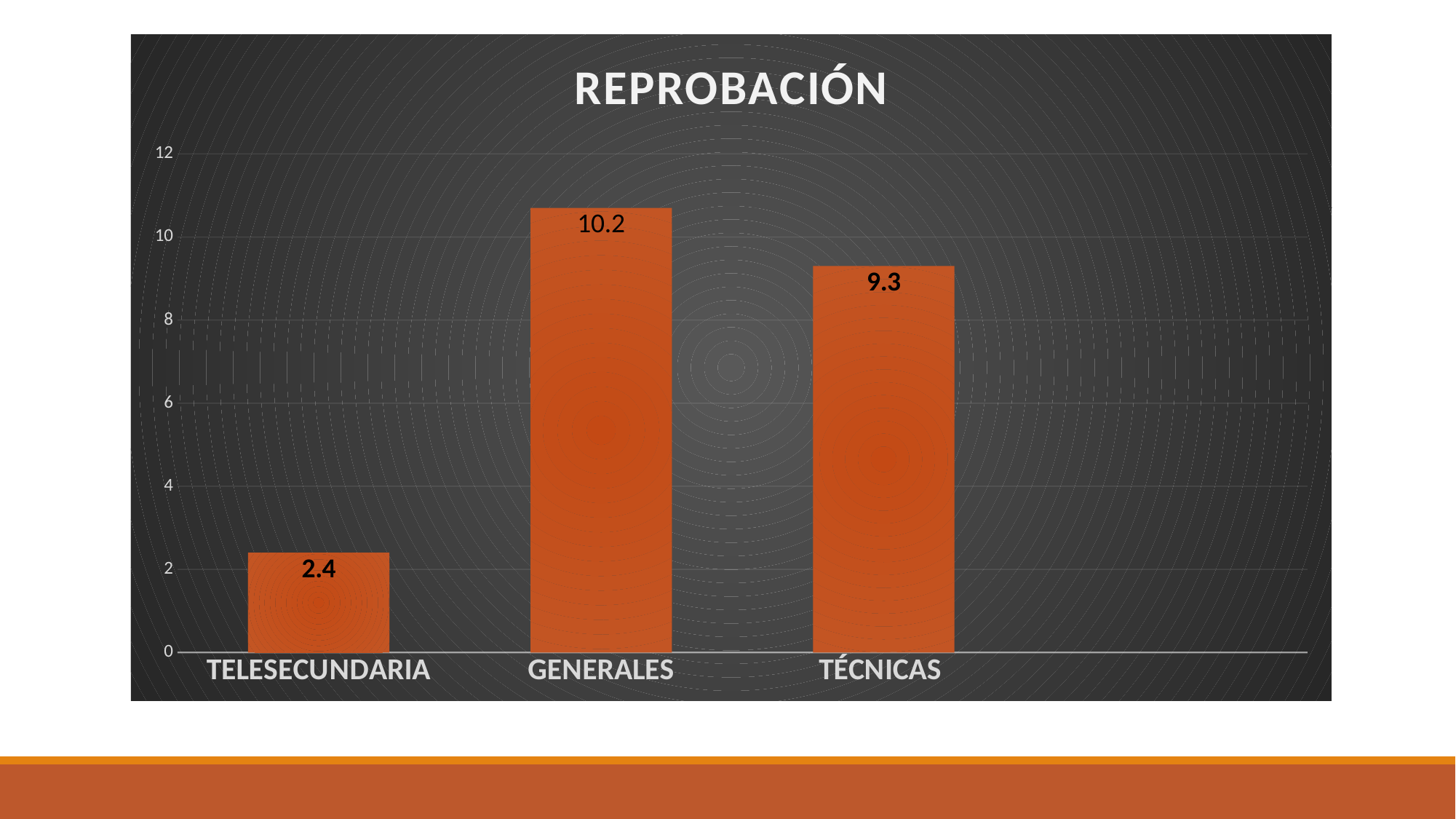
What kind of chart is shown on the slide? bar chart What is the value for GENERALES? 10.2 Which category has the highest value? GENERALES What is the difference between the values for GENERALES and TÉCNICAS? 0.9 Which is larger, the value for TÉCNICAS or the value for TELESECUNDARIA? TÉCNICAS What is the value for TELESECUNDARIA? 2.4 How many categories are shown on the chart? 3 Which category has the lowest value? TELESECUNDARIA What is the difference between the values for GENERALES and TELESECUNDARIA? 7.8 What is the title of the chart? REPROBACIÓN Is the value for TÉCNICAS greater or less than 8? greater What is the value for TÉCNICAS? 9.3